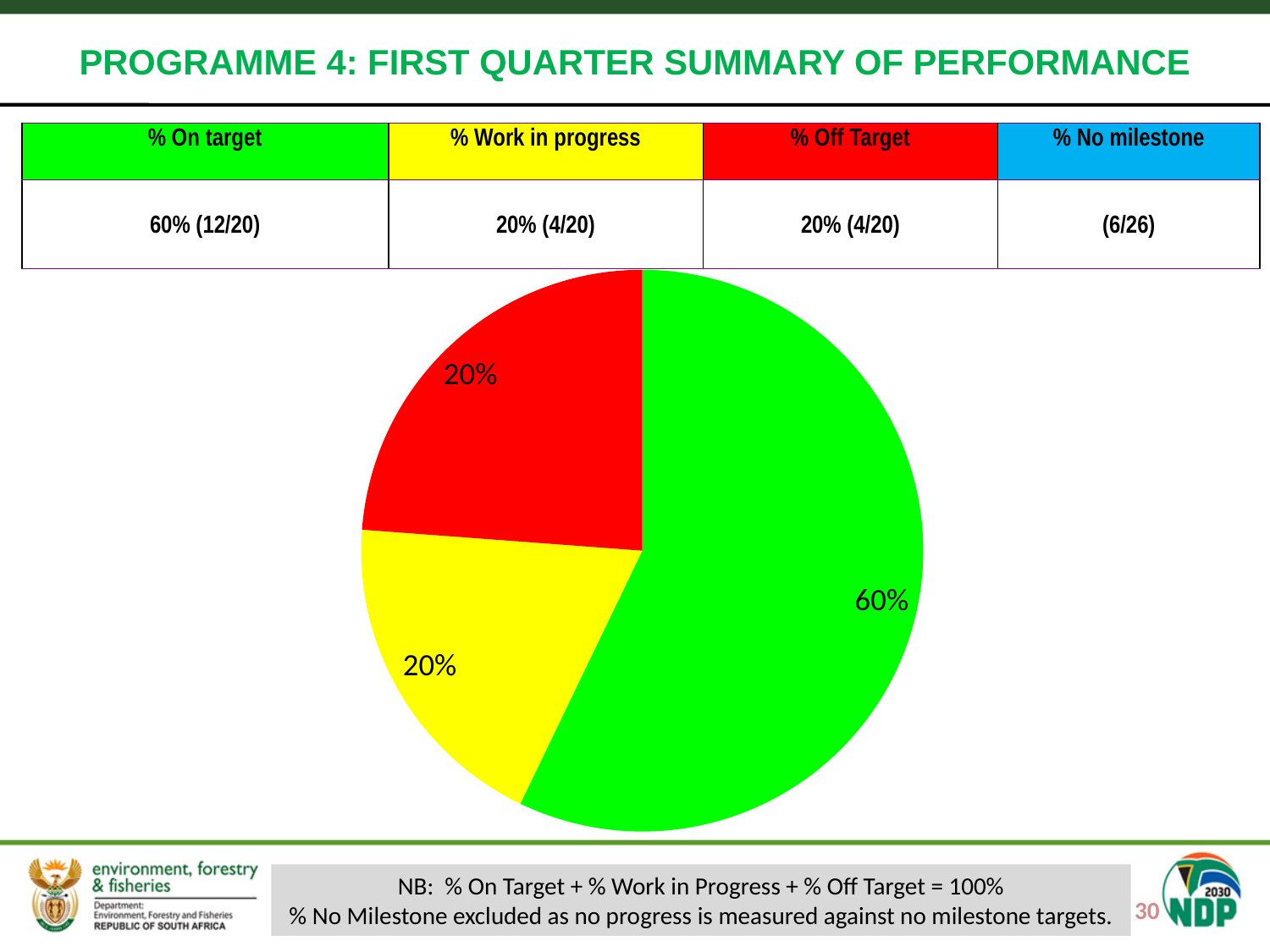
What share of the pie does the red (Off Target) slice represent? 20% What colour is the slice representing % Off Target in the pie chart? Red Is the share for the green slice greater or less than 50%? greater How many slices does the pie chart have? 3 What share of the pie does the green (On target) slice represent? 60% What is the title of the slide containing the pie chart? PROGRAMME 4: FIRST QUARTER SUMMARY OF PERFORMANCE What kind of chart is shown on the slide? Pie chart What share of the pie does the yellow (Work in progress) slice represent? 20% What is the combined share of the yellow and red slices in the pie chart? 40% Is the green slice of the pie chart larger or smaller than the red slice? Larger What is the difference between the On target share and the Off Target share in the pie chart? 40% Which slice of the pie chart is the largest? Green (On target), 60%